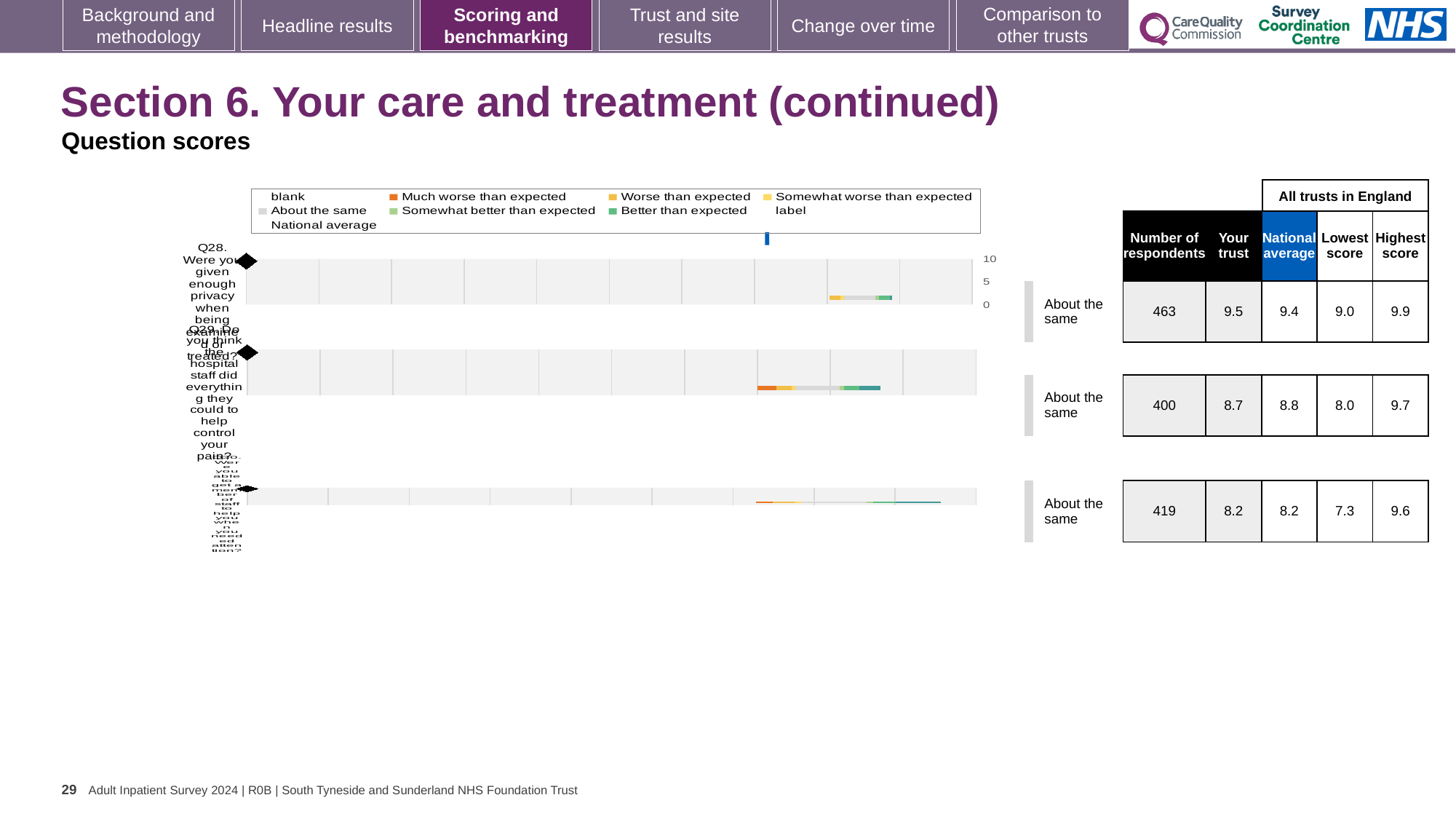
For Q29, which is larger: the 'Your trust' score or the national average? National average What is the national average score for Q29 (staff did everything to help control your pain)? 8.8 For Q30, is the 'Your trust' score higher than, lower than, or the same as the national average? The same How many questions (rows) are plotted on this slide? 3 What benchmark category is shown next to the Q28 chart? About the same Which question has the highest 'Your trust' score? Q28 Which question has the lowest 'Lowest score' among all trusts in England? Q30 For Q28, what is the difference between the highest score and the lowest score across all trusts in England? 0.9 What is the 'Your trust' score for Q28 (privacy when being examined or treated)? 9.5 How many respondents answered Q30 (the bottom row)? 419 What kind of chart is used to show the question scores on this slide? Bar chart